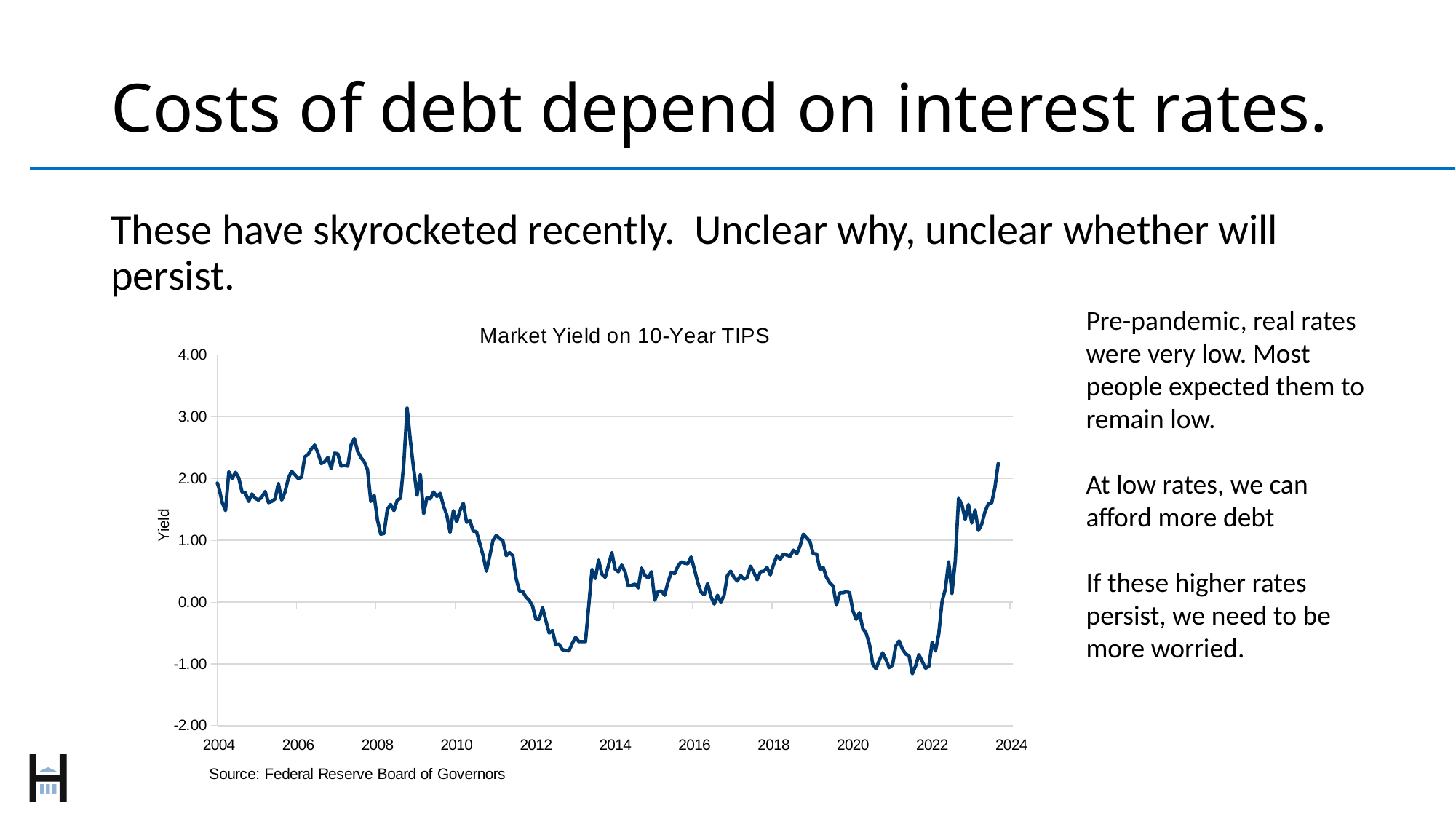
What is the label on the vertical axis of the chart? Yield Does the yield generally rise or fall between 2008 and 2012? fall Is the yield in 2016 greater or less than 1.00? less What is the title of the chart? Market Yield on 10-Year TIPS Is the yield in 2006 greater or less than 1.00? greater Is the yield at the start of 2021 greater or less than 0.00? less Does the yield generally rise or fall between 2022 and 2024? rise How many year labels are shown on the x axis of the chart? 11 What kind of chart is shown on the slide? line chart